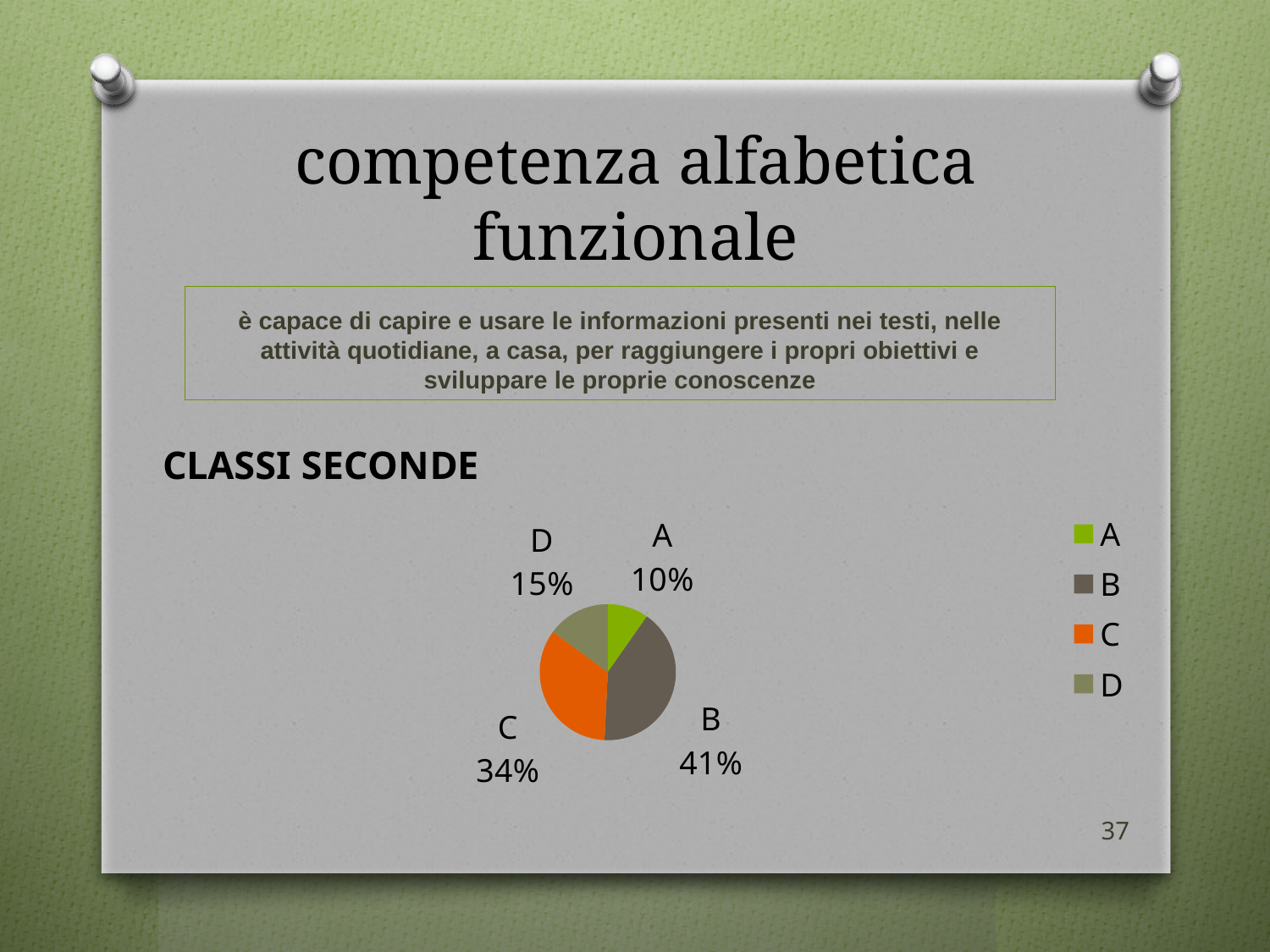
What percentage does slice A represent in the pie chart? 10% Which category has the smallest share of the pie chart? A What is the difference in percentage points between slice B and slice C? 7 What kind of chart is shown on the slide? pie chart Which category has the largest share of the pie chart? B What colour is the slice for category C in the pie chart? orange What percentage does slice B represent in the pie chart? 41% What percentage does slice C represent in the pie chart? 34% Which is larger, the share for D or the share for A? D What percentage does slice D represent in the pie chart? 15% How many entries does the legend list? 4 How many slices does the pie chart have? 4